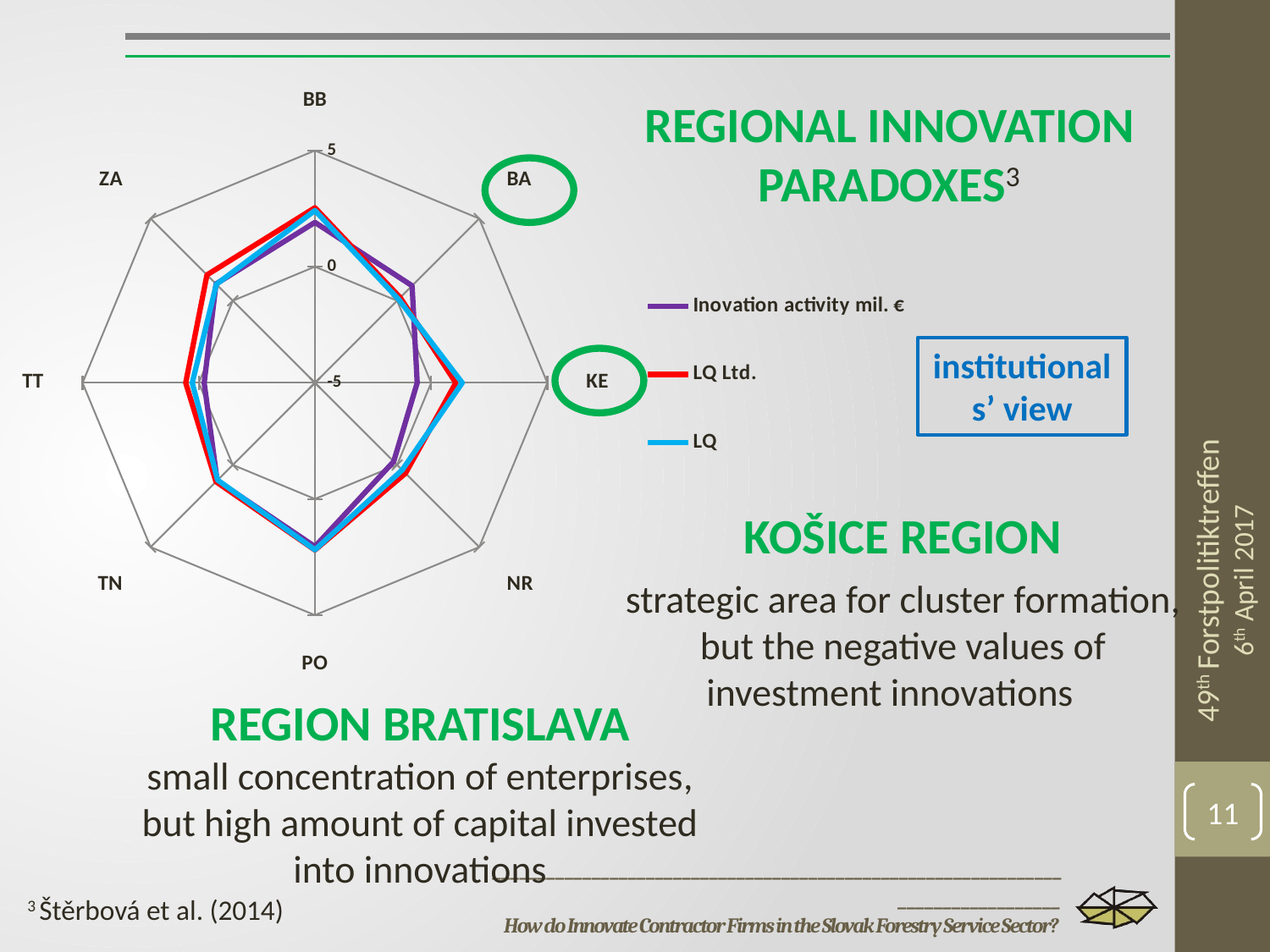
Which series in the radar chart is drawn in red? LQ Ltd. Which series in the radar chart is drawn in purple? Inovation activity mil. € Is the value for PO for the Inovation activity mil. € series greater or less than 5? less What kind of chart is shown on the slide? radar chart What is the highest value shown on the radar chart's axis scale? 5 How many series does the legend of the radar chart list? 3 Is the value for BB for the LQ Ltd. series greater or less than 5? less Is the value for BA for the Inovation activity mil. € series greater or less than 0? greater How many regions (categories) are plotted on the radar chart? 8